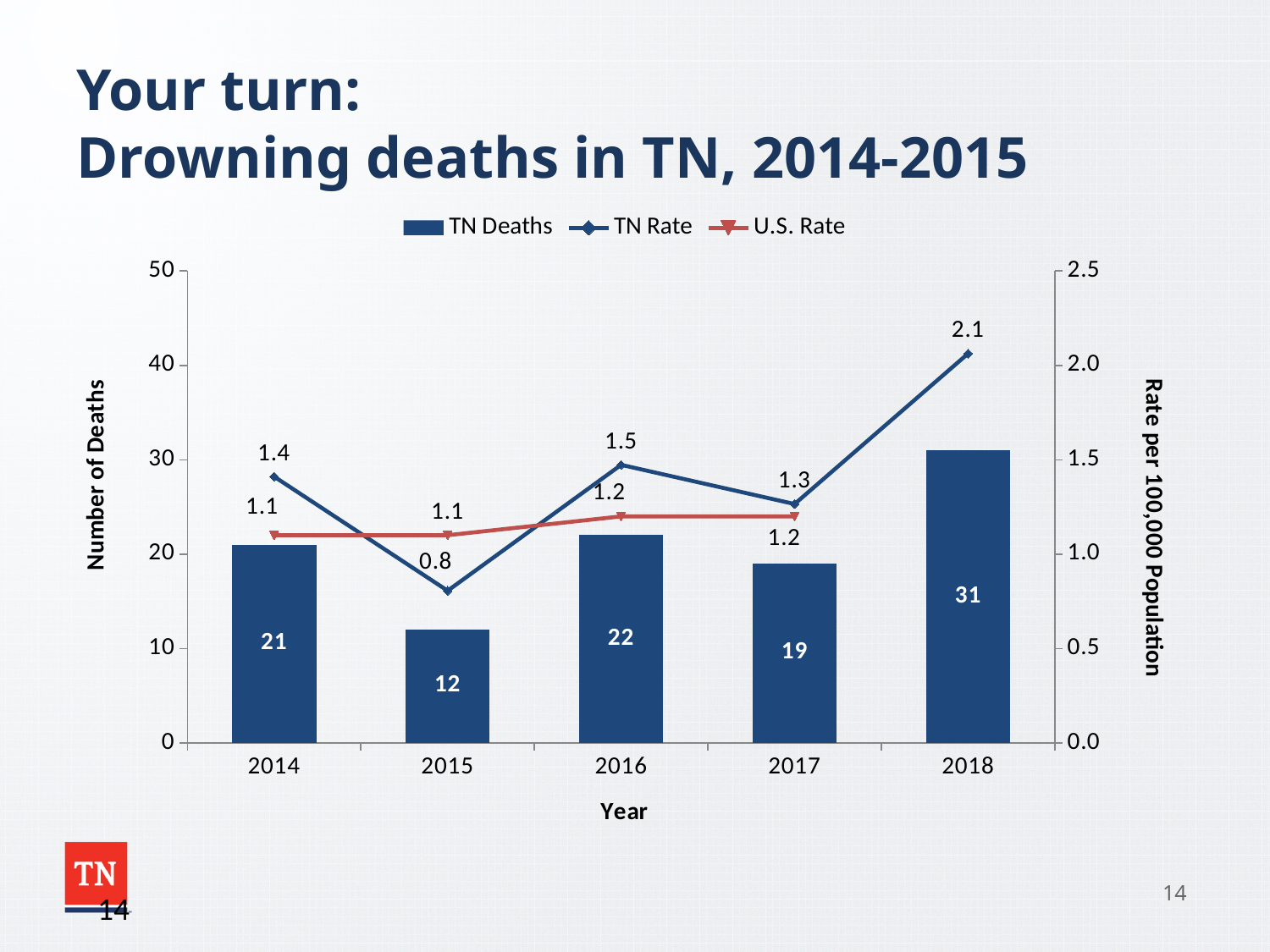
What is the label of the right-hand vertical axis? Rate per 100,000 Population What kind of chart is used to show TN Deaths? Bar chart What was the TN Rate in 2015? 0.8 What was the U.S. Rate in 2016? 1.2 How many TN deaths were recorded in 2018? 31 How many series does the legend list? 3 Which year had the highest number of TN deaths? 2018 Did the TN Rate rise or fall from 2017 to 2018? Rise What is the difference in TN deaths between 2018 and 2015? 19 Which year had the lowest TN Rate? 2015 Which was higher in 2014, the TN Rate or the U.S. Rate? TN Rate How many years are shown on the x axis? 5